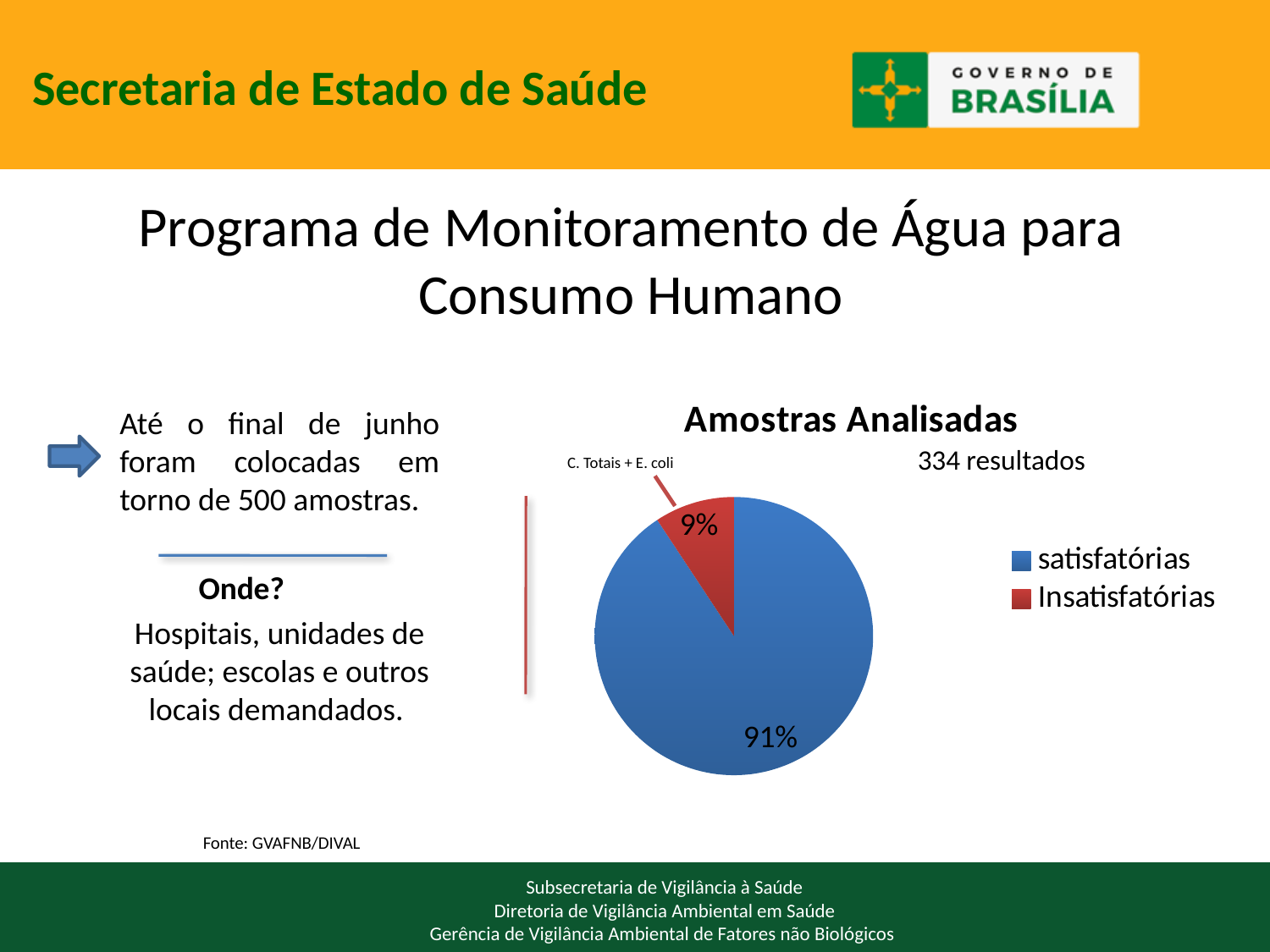
Which slice of the pie is the largest? satisfatórias What is the title of the chart? Amostras Analisadas Which slice of the pie is the smallest? Insatisfatórias What kind of chart is shown on the slide? pie chart What is the difference in percentage points between the satisfatórias and Insatisfatórias slices? 82 Which slice is larger, satisfatórias or Insatisfatórias? satisfatórias What colour is the Insatisfatórias slice? red How many entries does the legend list? 2 What annotation is attached to the 9% slice? C. Totais + E. coli How many slices does the pie chart have? 2 What percentage of the pie is labelled Insatisfatórias? 9% What percentage of the pie is labelled satisfatórias? 91%